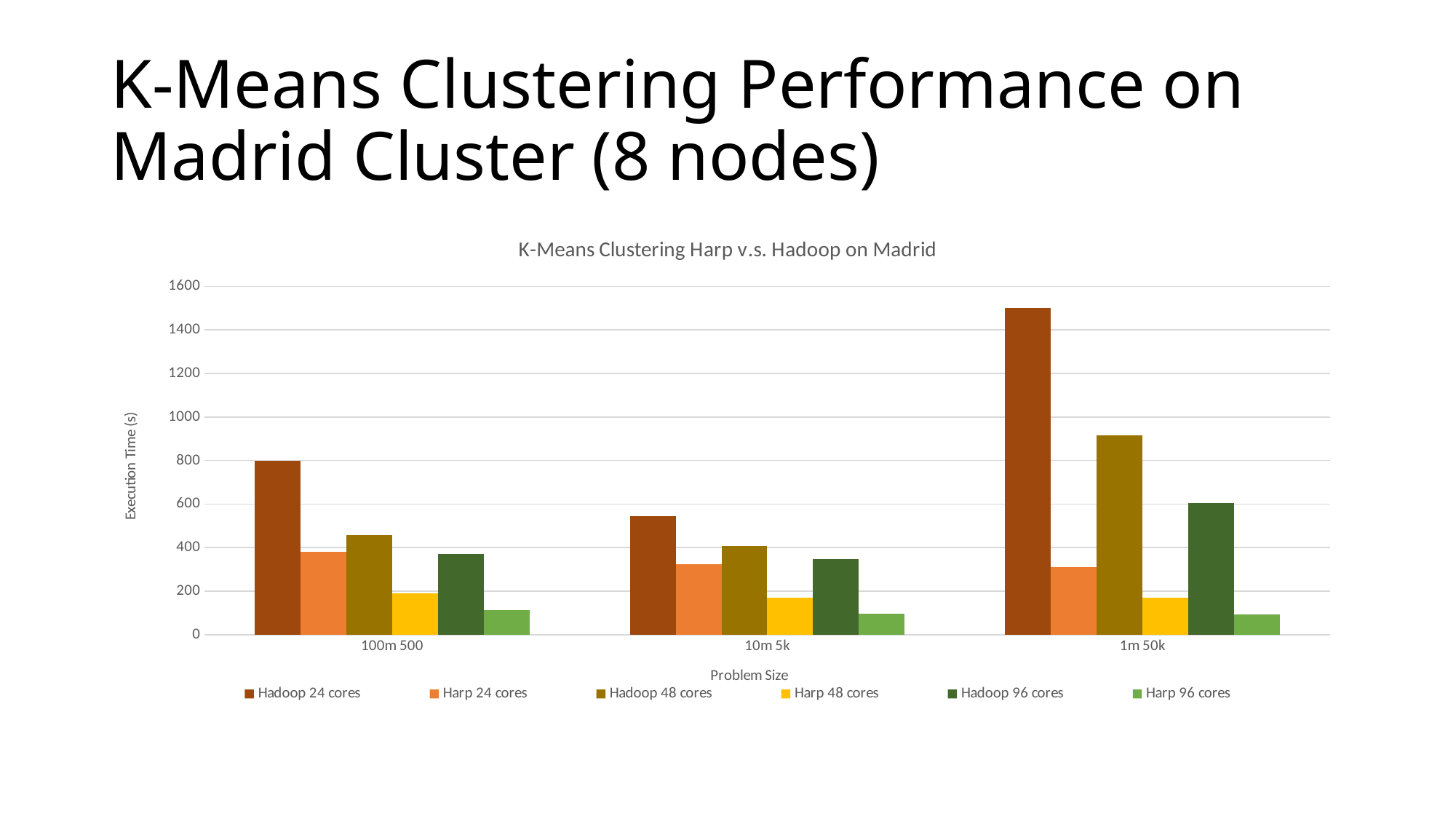
Which series has the lowest bar at 1m 50k? Harp 96 cores Is the value for Harp 96 cores at 10m 5k greater or less than 200? less Is the value for Hadoop 24 cores at 100m 500 greater or less than 600? greater For which problem size is the Hadoop 24 cores bar the highest? 1m 50k What is the label of the y axis? Execution Time (s) At 100m 500, which is larger: Harp 48 cores or Hadoop 96 cores? Hadoop 96 cores Is the value for Hadoop 48 cores at 1m 50k greater or less than 800? greater How many problem sizes are shown on the x axis? 3 How many series does the legend list? 6 At 1m 50k, which is larger: Hadoop 48 cores or Hadoop 96 cores? Hadoop 48 cores What kind of chart is shown on the slide? bar chart